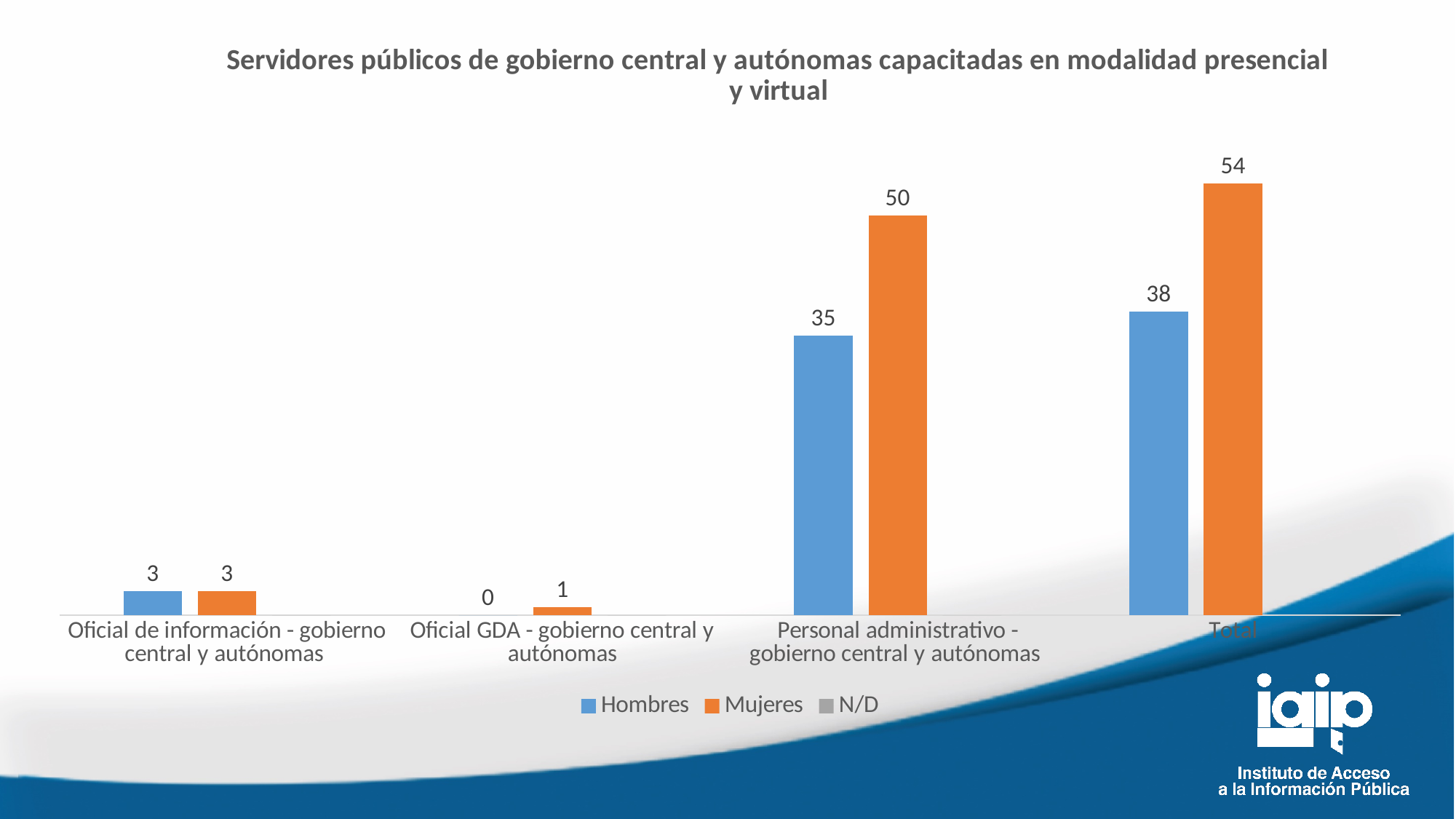
Which category has the lowest Hombres value? Oficial GDA - gobierno central y autónomas What is the value for Mujeres in the Personal administrativo - gobierno central y autónomas category? 50 How many categories are shown on the x axis? 4 Which category has the highest Mujeres value? Total What is the difference between Mujeres and Hombres in the Personal administrativo - gobierno central y autónomas category? 15 How many series does the legend list? 3 What kind of chart is shown on the slide? Bar chart What is the value for Mujeres in the Oficial GDA - gobierno central y autónomas category? 1 Which is larger in the Personal administrativo - gobierno central y autónomas category, Hombres or Mujeres? Mujeres What is the difference between Mujeres and Hombres in the Total category? 16 What is the value for Hombres in the Total category? 38 What is the value for Hombres in the Oficial de información - gobierno central y autónomas category? 3